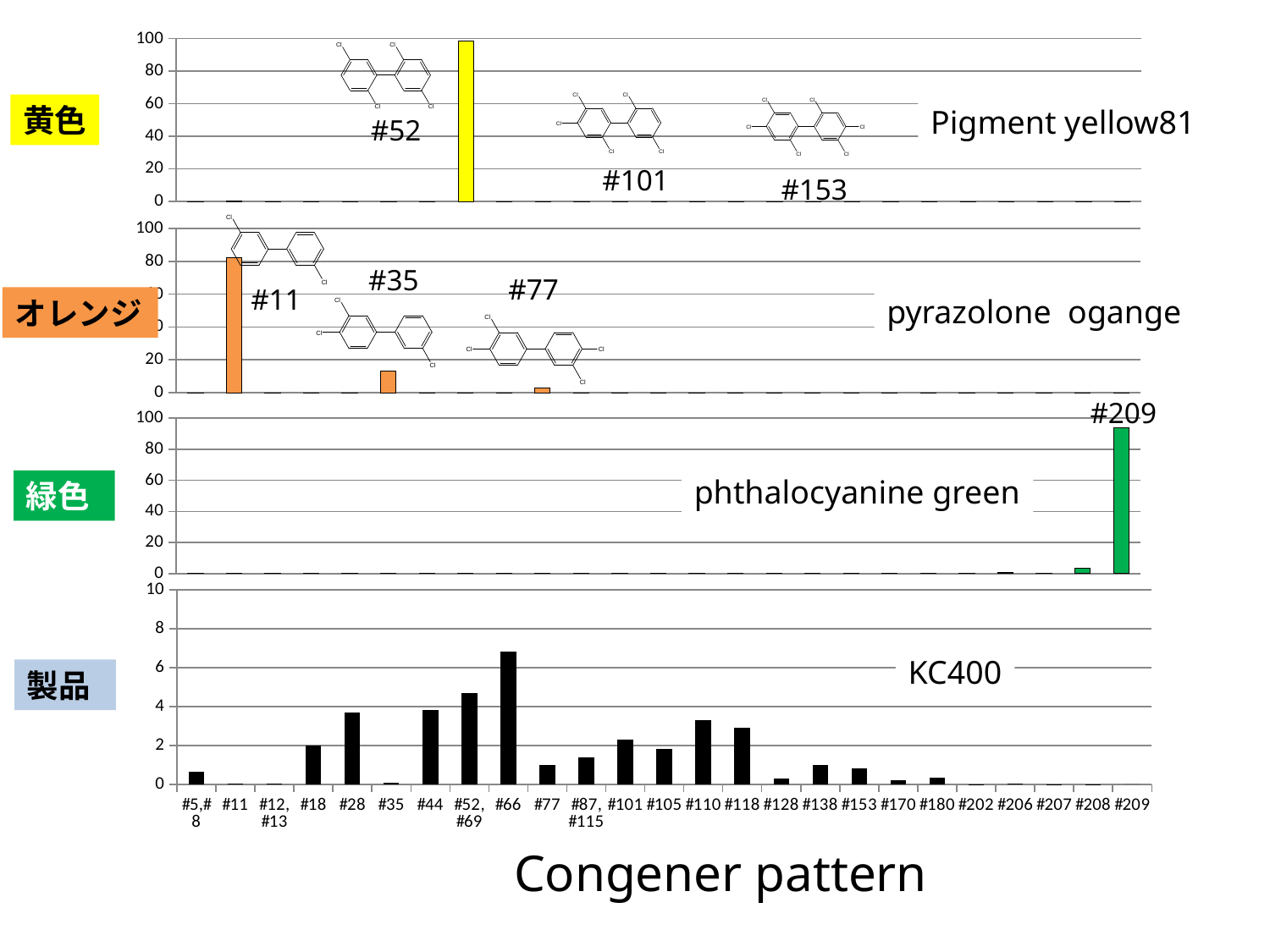
In the pyrazolone orange chart (second from top), is the value for #11 greater or less than 60? greater In the phthalocyanine green chart (third from top), which congener has the highest bar? #209 In the phthalocyanine green chart (third from top), is the value for #209 greater or less than 80? greater In the Pigment yellow81 chart (top), is the value for #52 greater or less than 80? greater In the pyrazolone orange chart (second from top), which congener has the highest bar? #11 In the pyrazolone orange chart (second from top), which is larger, the value for #35 or the value for #77? #35 What kind of chart is the KC400 chart at the bottom of the slide? bar chart In the Pigment yellow81 chart (top), which congener has the highest bar? #52 In the KC400 chart (bottom), which is larger, the value for #28 or the value for #66? #66